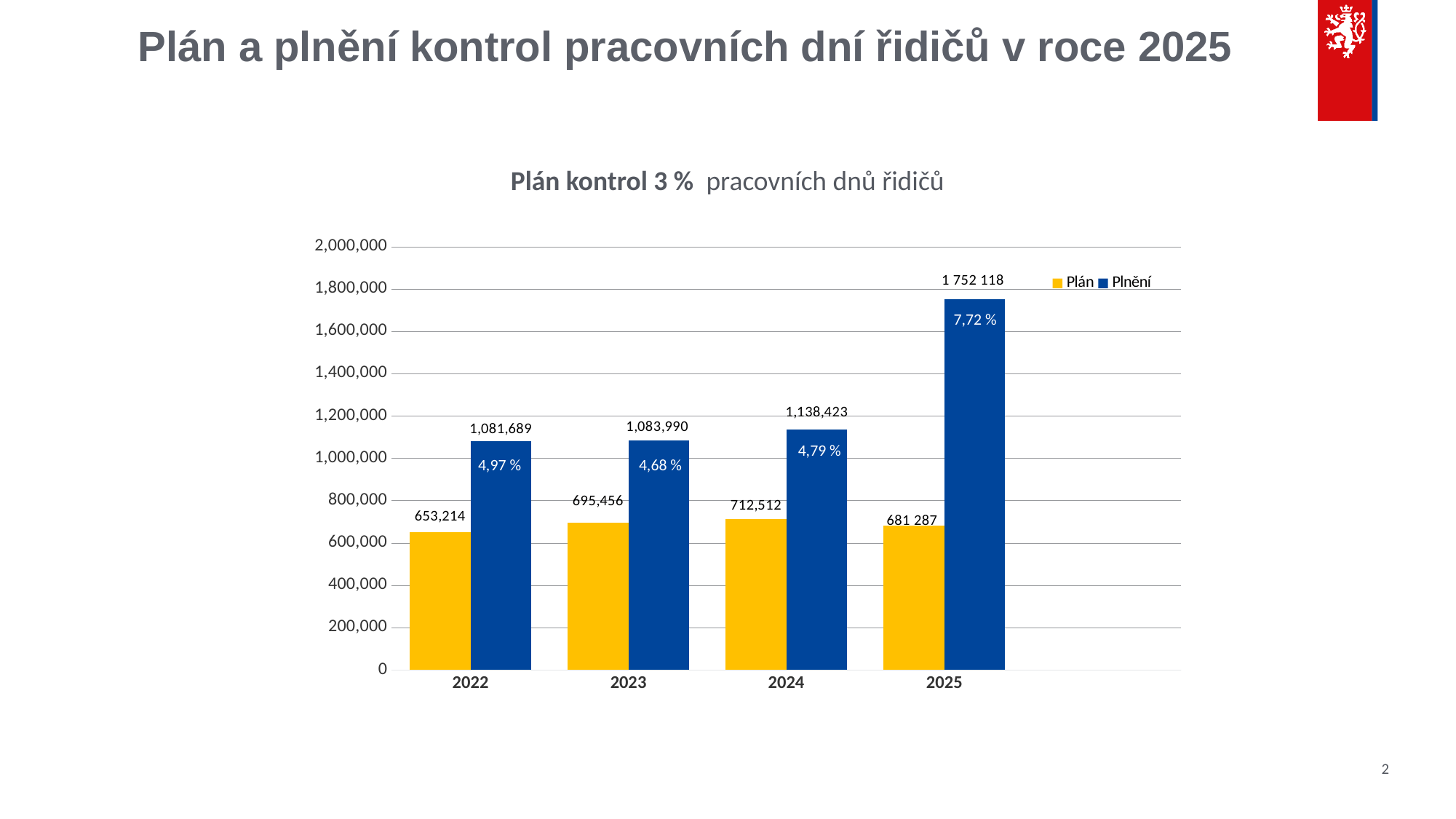
How many series does the legend list? 2 Is the Plán value for 2023 greater or less than 800,000? less What percentage is shown inside the Plnění bar for 2024? 4,79 % Does the Plnění value rise or fall from 2022 to 2025? rise Which is larger in 2023, the Plán value or the Plnění value? Plnění How many years are shown on the x axis? 4 What is the Plnění value for 2025? 1 752 118 Which year has the highest Plnění value? 2025 What is the Plán value for 2022? 653,214 Which year has the lowest Plán value? 2022 What is the difference between Plnění and Plán in 2022? 428,475 What is the Plán value for 2024? 712,512